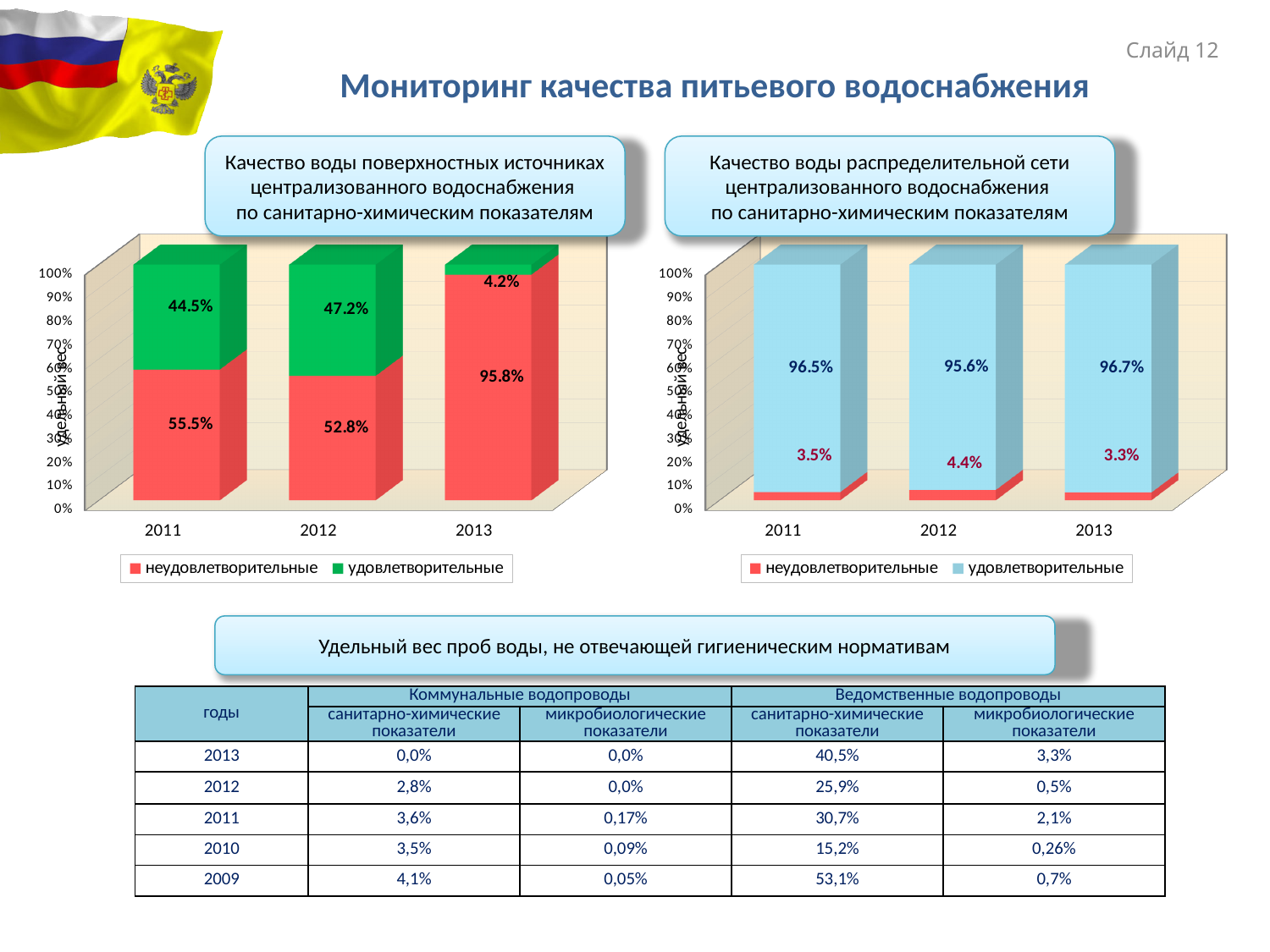
How many series does the legend of the right chart (distribution network) list? 2 In the left chart (surface water sources), what is the value for удовлетворительные in 2011? 44.5% In the right chart (distribution network), what is the value for удовлетворительные in 2013? 96.7% In the right chart (distribution network), which year has the lowest value for неудовлетворительные? 2013 In the left chart (surface water sources), what is the difference between the неудовлетворительные values for 2013 and 2012? 43.0% In the right chart (distribution network), which is larger: the удовлетворительные value for 2011 or for 2012? 2011 In the left chart (surface water sources), which year has the highest value for неудовлетворительные? 2013 In the left chart (surface water sources), what is the value for неудовлетворительные in 2013? 95.8% In the right chart (distribution network), what is the value for неудовлетворительные in 2012? 4.4% How many years are shown on the x axis of the left chart (surface water sources)? 3 What kind of chart is the left chart (surface water sources)? Stacked bar chart In the left chart (surface water sources), does the value for удовлетворительные rise or fall from 2012 to 2013? Fall